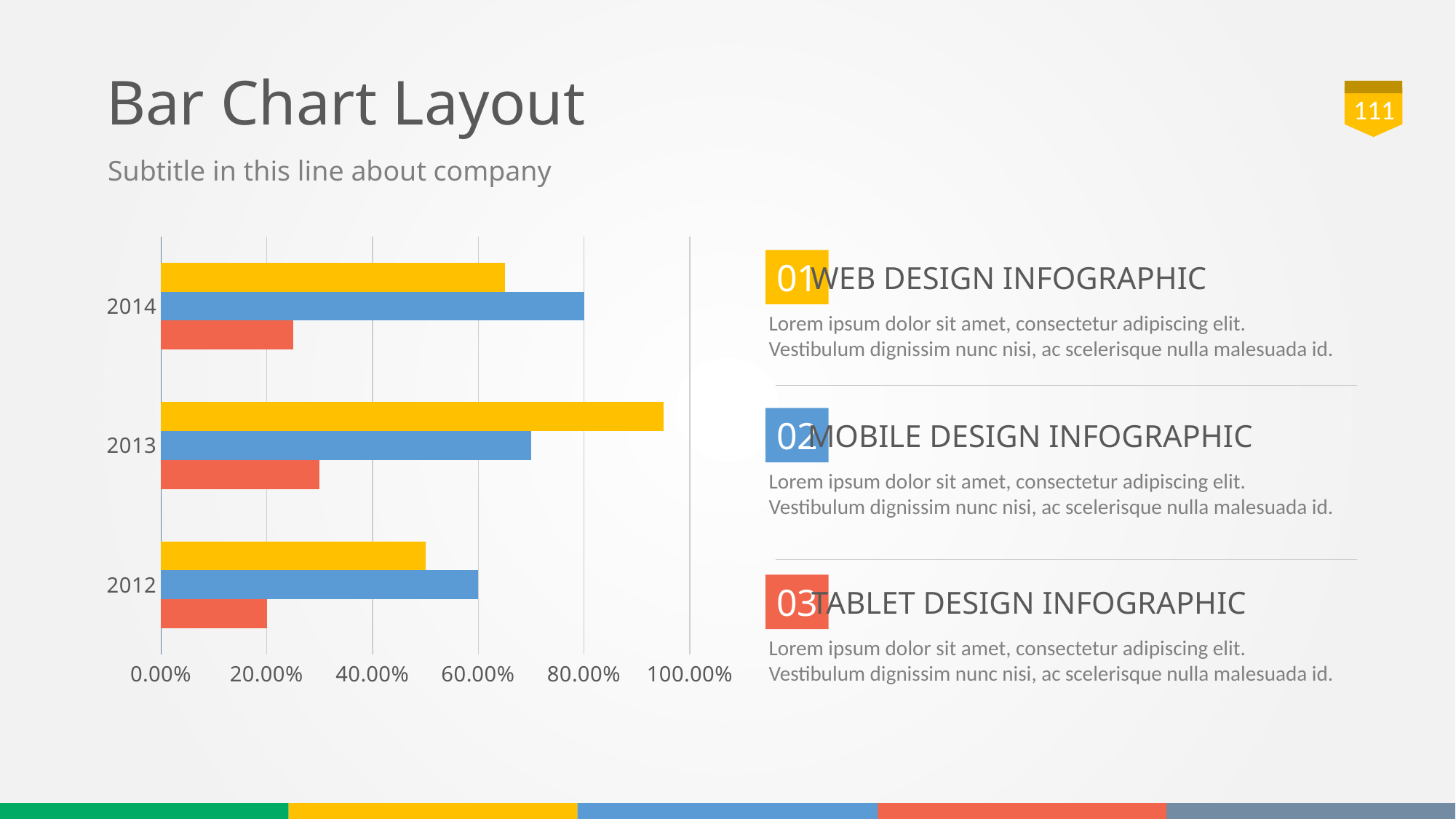
What is the value of the red bar for 2012? 20.00% Which is larger, the blue bar for 2014 or the blue bar for 2013? 2014 Which year has the shortest red bar? 2012 What kind of chart is shown on the slide? bar chart What is the highest value labelled on the chart's horizontal axis? 100.00% Is the value of the red bar for 2014 greater or less than 40.00%? less Is the value of the yellow bar for 2014 greater or less than 60.00%? greater Is the value of the yellow bar for 2013 greater or less than 80.00%? greater What is the value of the blue bar for 2014? 80.00% How many year categories are shown on the chart's vertical axis? 3 What is the value of the blue bar for 2012? 60.00% Which year has the longest yellow bar? 2013